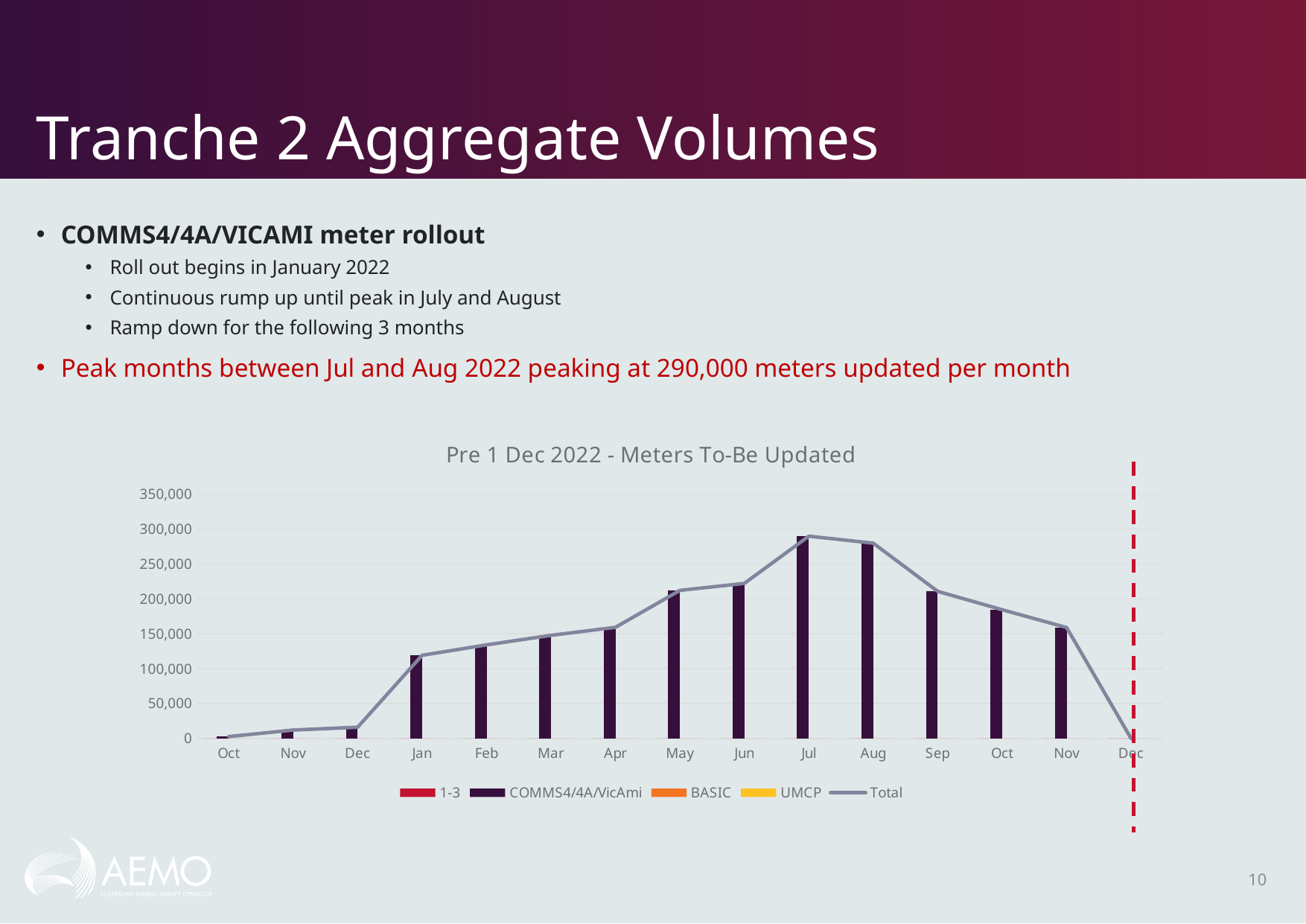
Is the value for Aug greater or less than 250,000? greater What kind of chart is shown on the slide? Bar chart with a line Do the values rise or fall from Jan to Jul? rise Which is larger, the value for Jul or the value for Jan? Jul How many months are shown on the x axis of the chart? 15 What is the title of the chart? Pre 1 Dec 2022 - Meters To-Be Updated Which is larger, the value for May or the value for Feb? May Is the value for the first Dec on the x axis greater or less than 50,000? less Is the value for Jul greater or less than 250,000? greater How many series does the chart legend list? 5